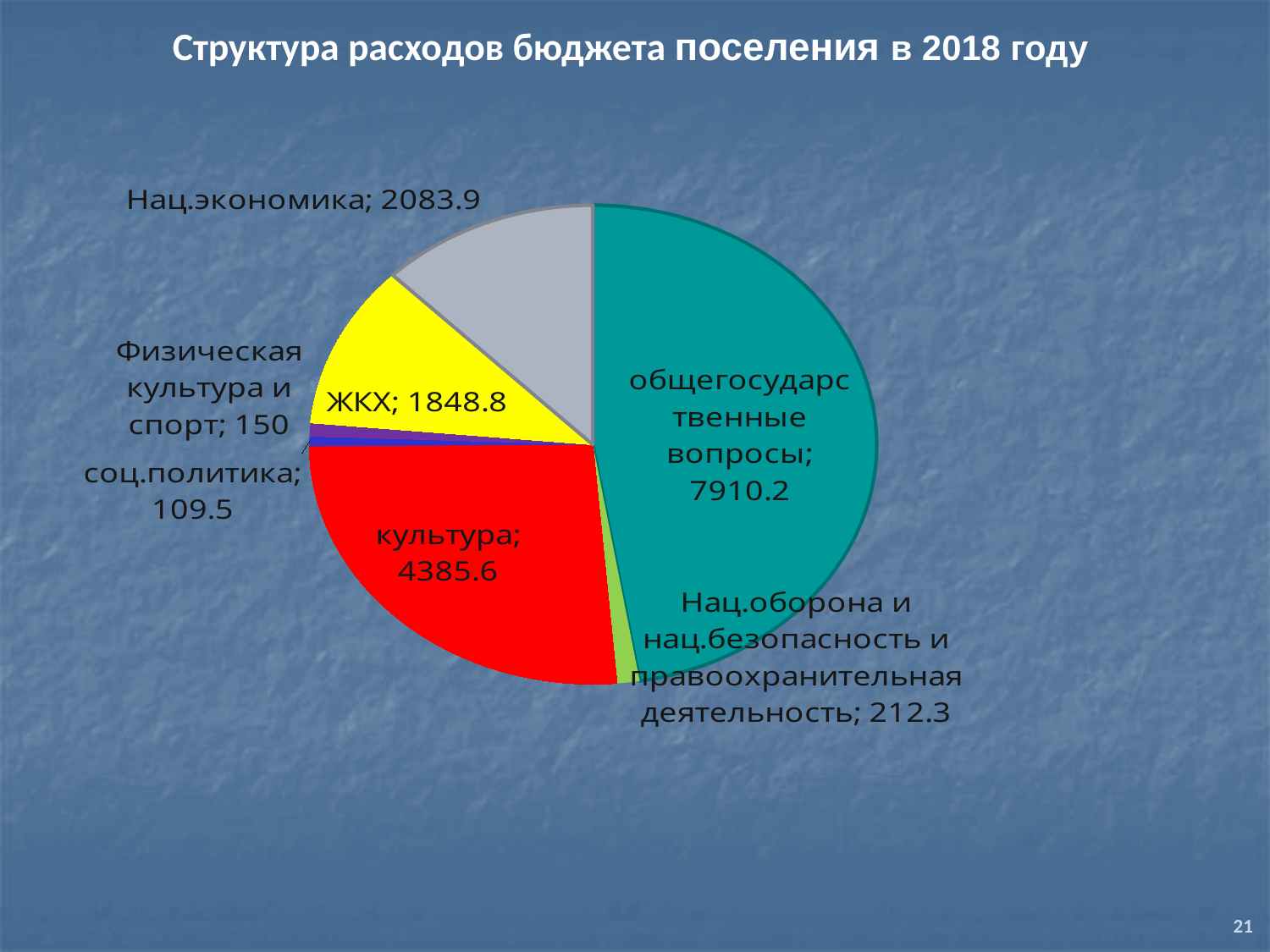
Which is larger, Нац.экономика or ЖКХ? Нац.экономика What is the value for ЖКХ? 1848.8 What is the value for общегосударственные вопросы? 7910.2 How many slices does the pie chart have? 7 What is the difference between общегосударственные вопросы and культура? 3524.6 What is the title of the chart? Структура расходов бюджета поселения в 2018 году What is the value for соц.политика? 109.5 Which category has the smallest value? соц.политика What colour is the slice for культура? red What kind of chart is shown on the slide? pie chart What is the value for культура? 4385.6 Which category has the largest value? общегосударственные вопросы